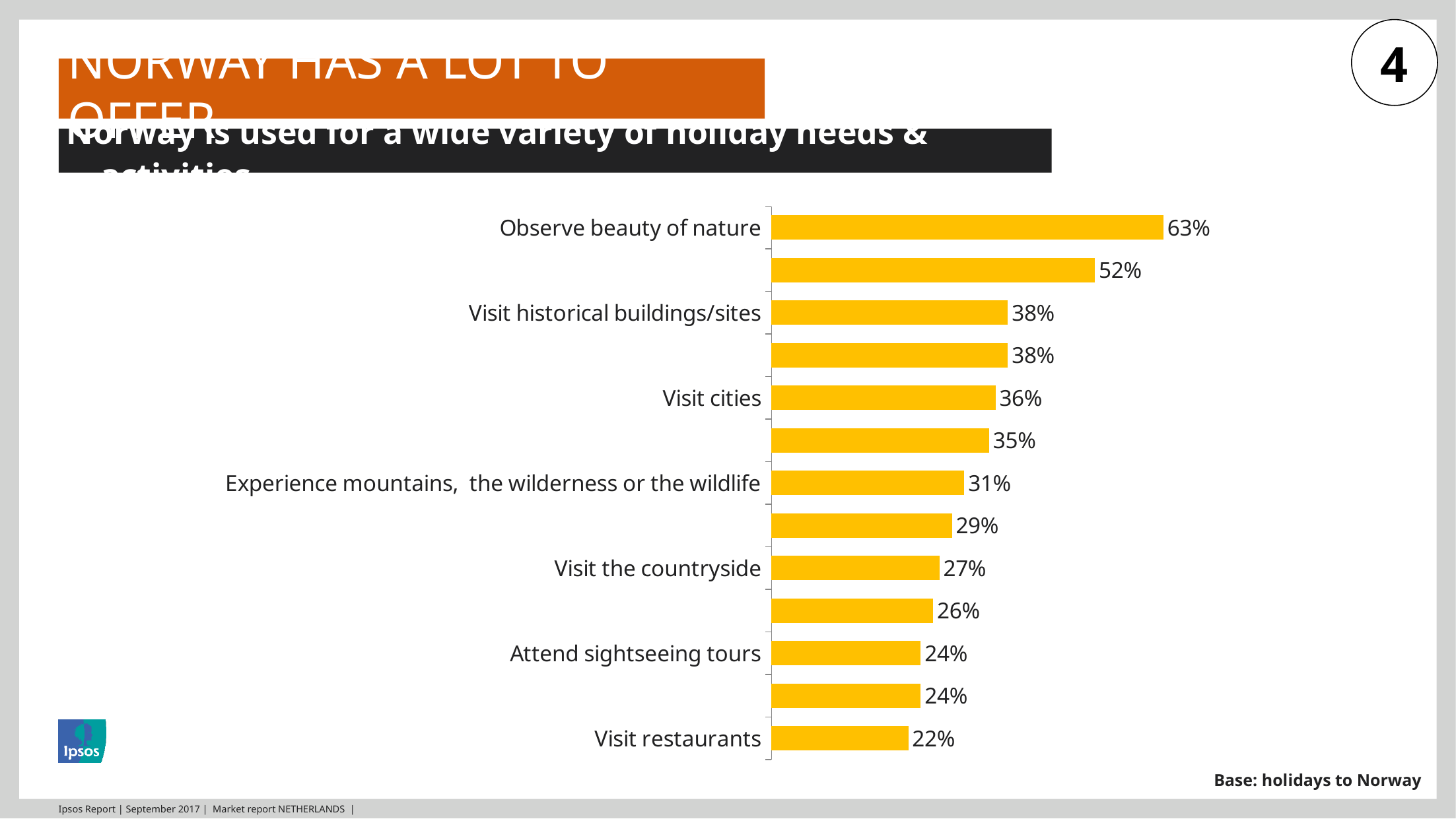
What is the value for 'Experience mountains, the wilderness or the wildlife'? 31% What percentage is shown for 'Visit restaurants'? 22% Which activity has the lowest percentage? Visit restaurants What colour are the bars in the chart? Yellow What percentage is shown for 'Observe beauty of nature'? 63% How many bars are plotted in the chart? 13 Which activity has the highest percentage? Observe beauty of nature Which has a higher value, 'Visit cities' or 'Visit the countryside'? Visit cities What type of chart is shown on the slide? Bar chart What is the value for 'Visit historical buildings/sites'? 38% What is the difference in percentage points between 'Observe beauty of nature' and 'Visit restaurants'? 41 What percentage is shown for 'Visit cities'? 36%